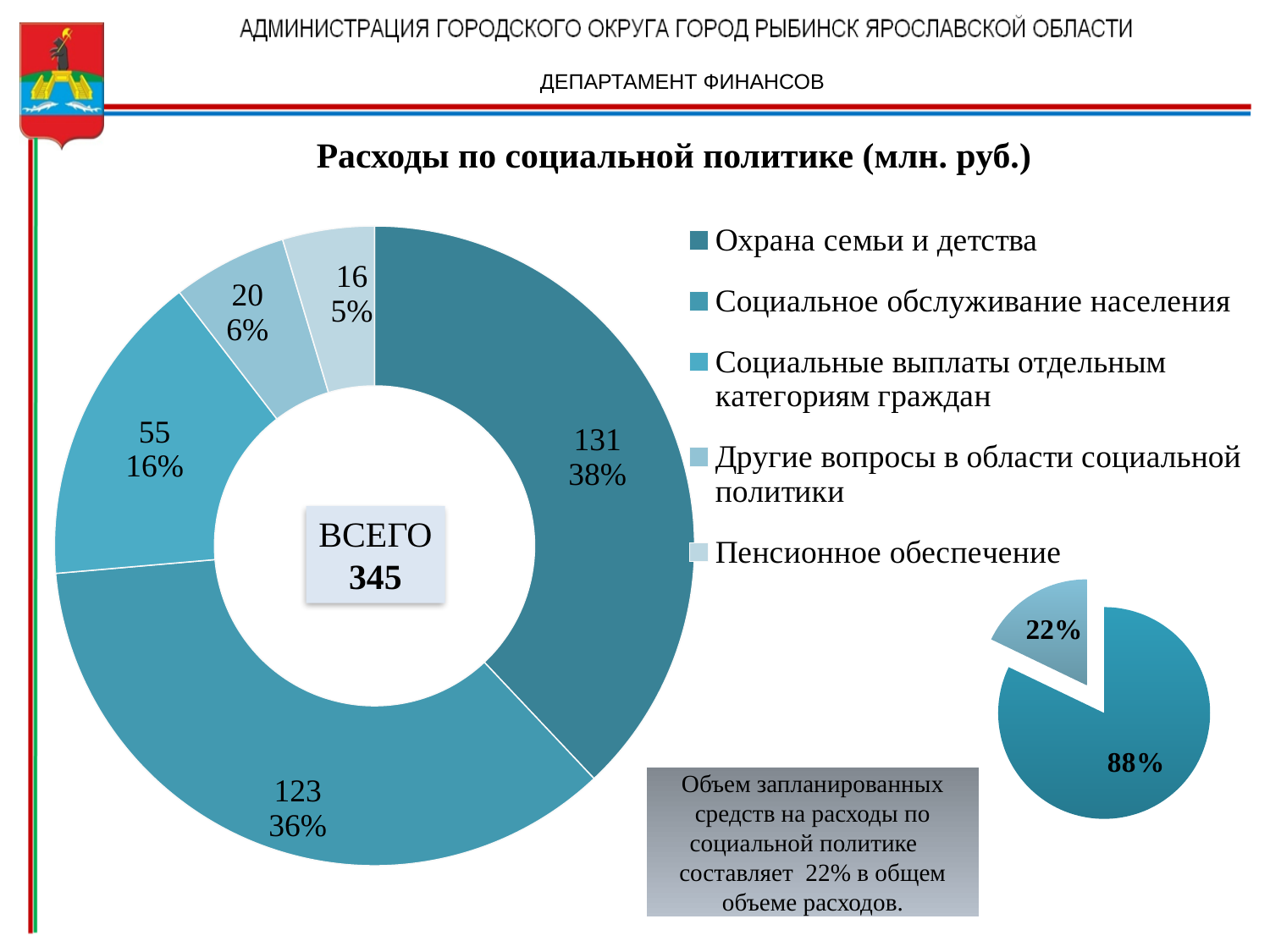
On the small pie chart at the bottom right of the slide, what is the share of the smaller, separated slice? 22% On the doughnut chart 'Расходы по социальной политике (млн. руб.)', which category has the highest value? Охрана семьи и детства On the doughnut chart 'Расходы по социальной политике (млн. руб.)', how many categories are shown? 5 On the doughnut chart 'Расходы по социальной политике (млн. руб.)', which is larger: 'Социальные выплаты отдельным категориям граждан' or 'Другие вопросы в области социальной политики'? Социальные выплаты отдельным категориям граждан On the doughnut chart 'Расходы по социальной политике (млн. руб.)', what is the total shown in the centre? 345 On the doughnut chart 'Расходы по социальной политике (млн. руб.)', what is the value for 'Пенсионное обеспечение'? 16 How many slices does the small pie chart at the bottom right of the slide have? 2 On the doughnut chart 'Расходы по социальной политике (млн. руб.)', what share does 'Социальное обслуживание населения' have? 36% What kind of chart is the large chart titled 'Расходы по социальной политике (млн. руб.)'? Doughnut chart On the doughnut chart 'Расходы по социальной политике (млн. руб.)', which category has the lowest value? Пенсионное обеспечение On the doughnut chart 'Расходы по социальной политике (млн. руб.)', what is the value for 'Охрана семьи и детства'? 131 On the doughnut chart 'Расходы по социальной политике (млн. руб.)', what is the difference between 'Охрана семьи и детства' and 'Социальное обслуживание населения'? 8